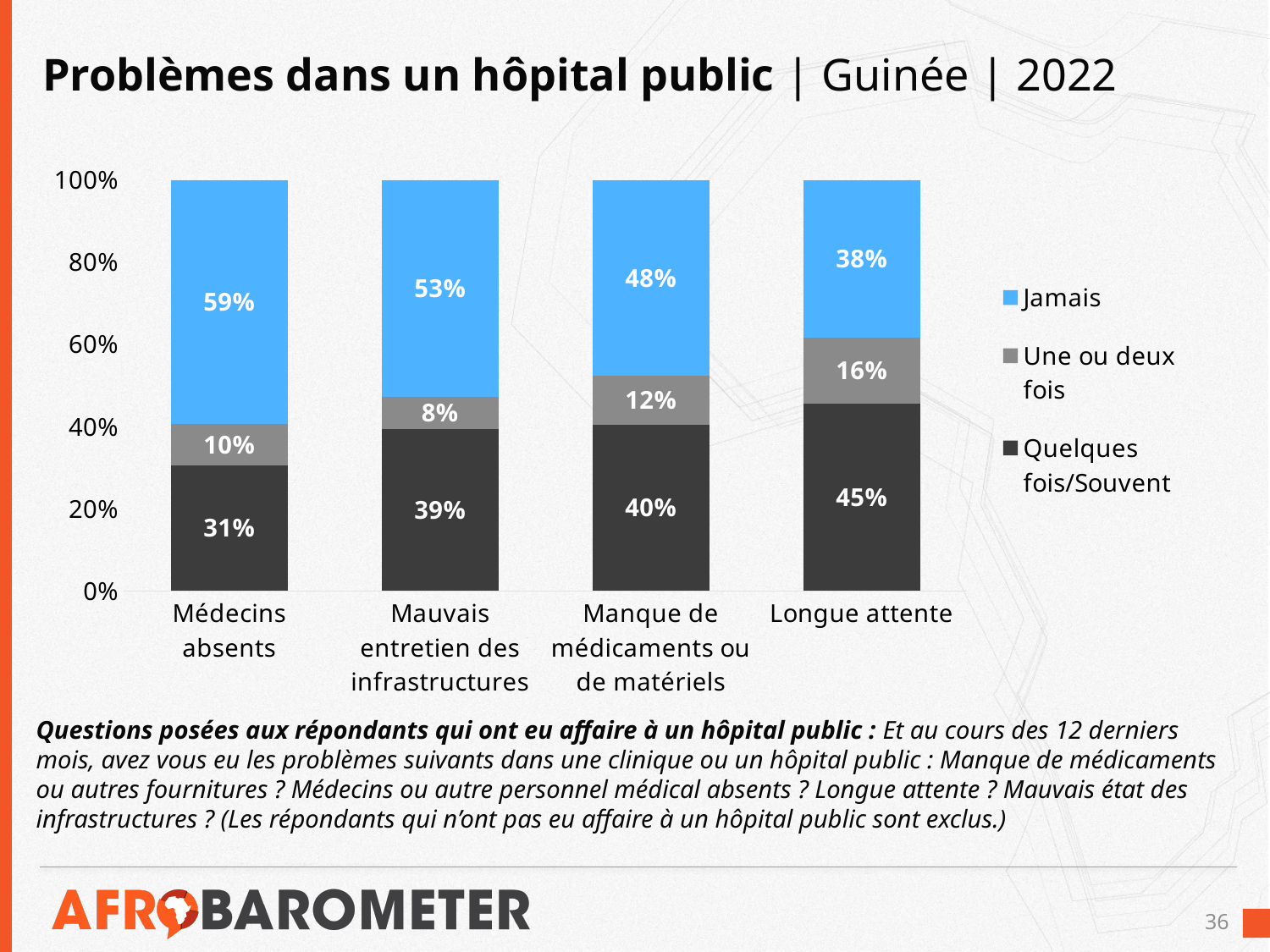
What percentage of respondents said they 'Jamais' experienced 'Médecins absents'? 59% What is the total of the 'Une ou deux fois' and 'Quelques fois/Souvent' segments for 'Longue attente'? 61% Which category has the lowest 'Jamais' value? Longue attente Which category has the highest 'Quelques fois/Souvent' value? Longue attente What is the 'Quelques fois/Souvent' value for 'Longue attente'? 45% What kind of chart is shown on the slide? Stacked bar chart Which is larger: the 'Quelques fois/Souvent' value for 'Mauvais entretien des infrastructures' or for 'Médecins absents'? Mauvais entretien des infrastructures What is the 'Une ou deux fois' value for 'Manque de médicaments ou de matériels'? 12% How many categories are shown on the x axis? 4 How many series does the legend list? 3 What is the difference between the 'Jamais' values for 'Médecins absents' and 'Longue attente'? 21 percentage points Do the 'Quelques fois/Souvent' values rise or fall from left to right along the x axis? Rise